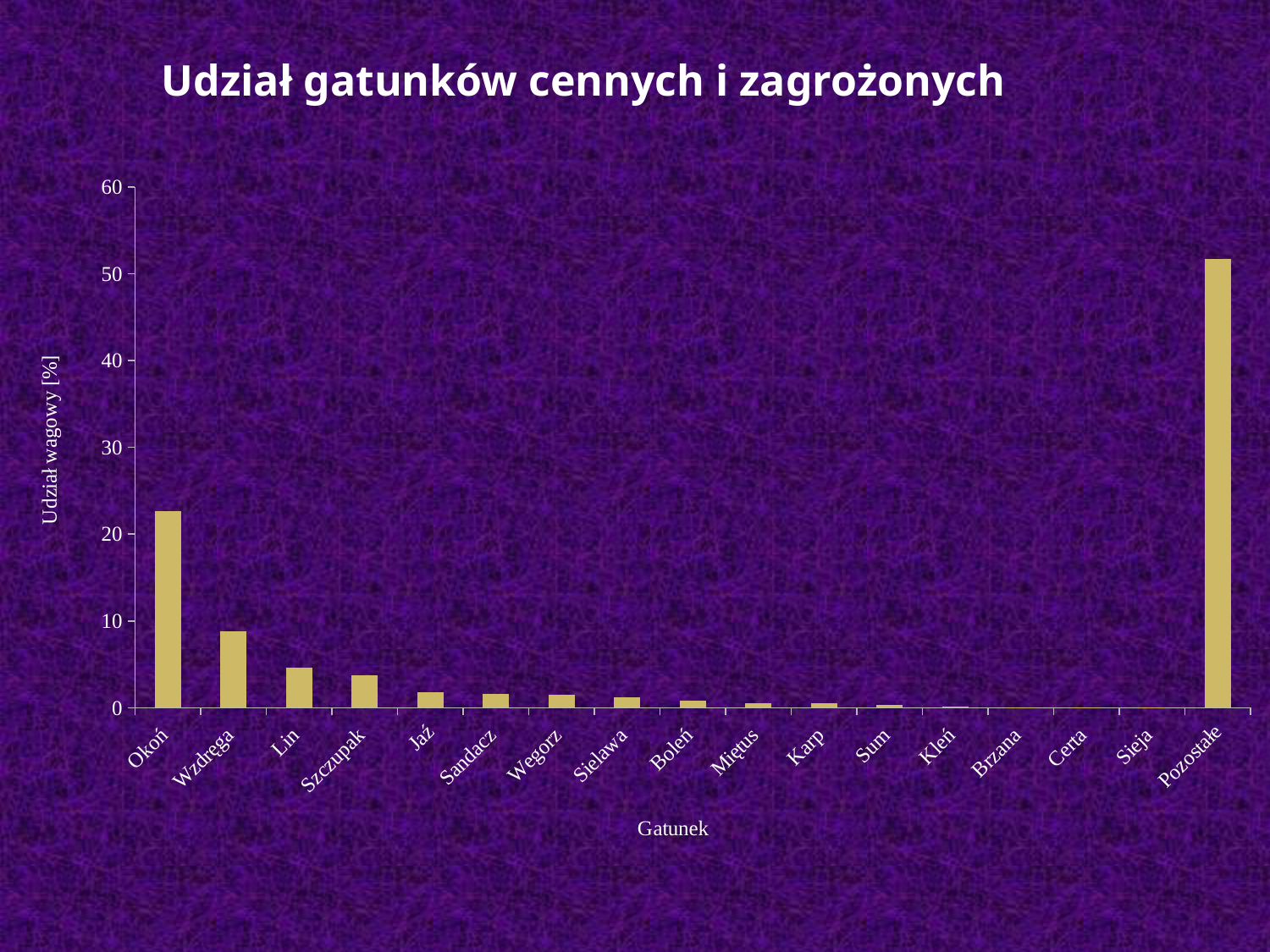
How many categories (species) are shown on the x axis of the chart? 17 Which has a larger value, Pozostałe or Okoń? Pozostałe Is the value for Wzdręga greater or less than 10? less What kind of chart is shown on the slide? bar chart Is the value for Pozostałe greater or less than 50? greater Do the values rise or fall along the x axis from Okoń to Sieja? fall What is the label of the y axis of the chart? Udział wagowy [%] Which has a larger value, Okoń or Wzdręga? Okoń Which has a larger value, Lin or Szczupak? Lin Is the value for Okoń greater or less than 20? greater Which category has the highest value in the chart? Pozostałe